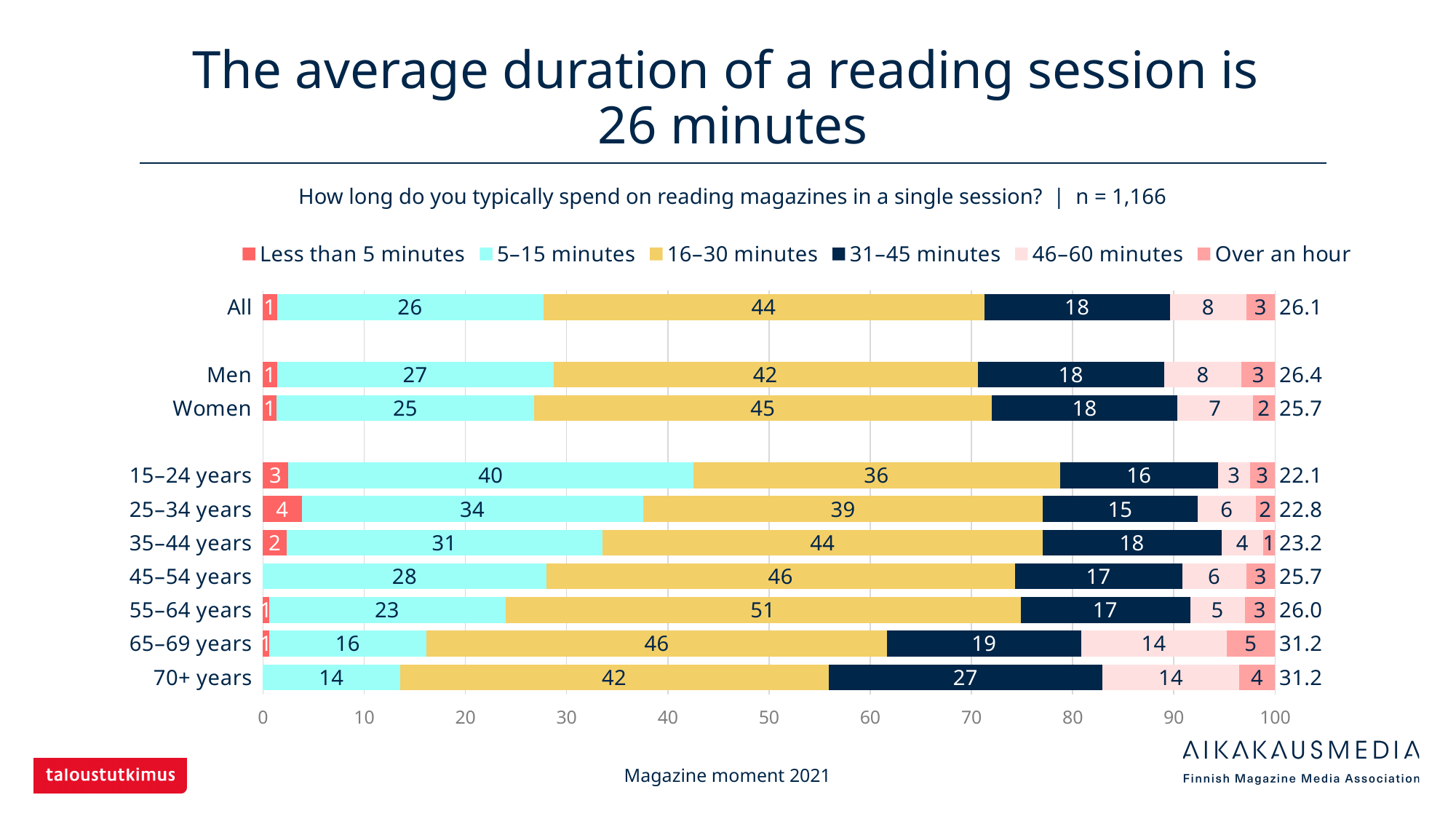
What is the value for the 46–60 minutes segment for 70+ years? 14 What kind of chart is shown on the slide? Stacked bar chart Which age group has the highest value for the 31–45 minutes segment? 70+ years What is the value for the Less than 5 minutes segment for 25–34 years? 4 What is the value for the 16–30 minutes segment in the All bar? 44 How many series does the legend list? 6 How many categories (bars) are shown on the chart? 10 Which age group has the lowest value for the 5–15 minutes segment? 70+ years What average duration in minutes is shown at the end of the 65–69 years bar? 31.2 What is the value for the 5–15 minutes segment for 15–24 years? 40 Which has the larger 5–15 minutes value, Men or Women? Men What is the difference between the 16–30 minutes values for 55–64 years and 15–24 years? 15